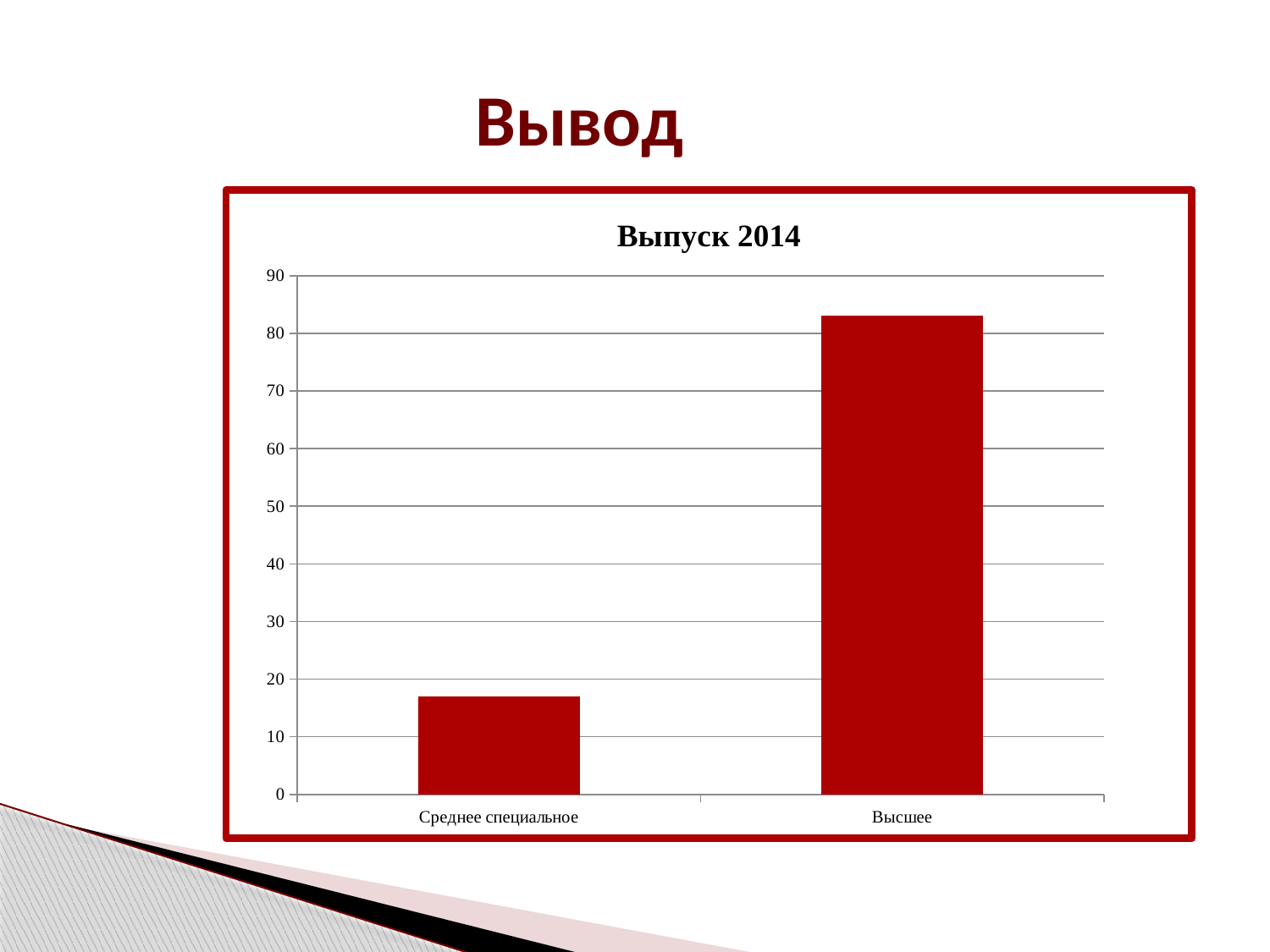
Is the value for Среднее специальное greater or less than 20? less How many categories are plotted in the chart? 2 Is the value for Высшее greater or less than 90? less Is the value for Высшее greater or less than 80? greater What is the title of the chart? Выпуск 2014 Which category has the lowest value? Среднее специальное Which is larger, the value for Среднее специальное or the value for Высшее? Высшее Which category has the highest value? Высшее What kind of chart is shown on the slide? bar chart What is the highest value shown on the vertical axis? 90